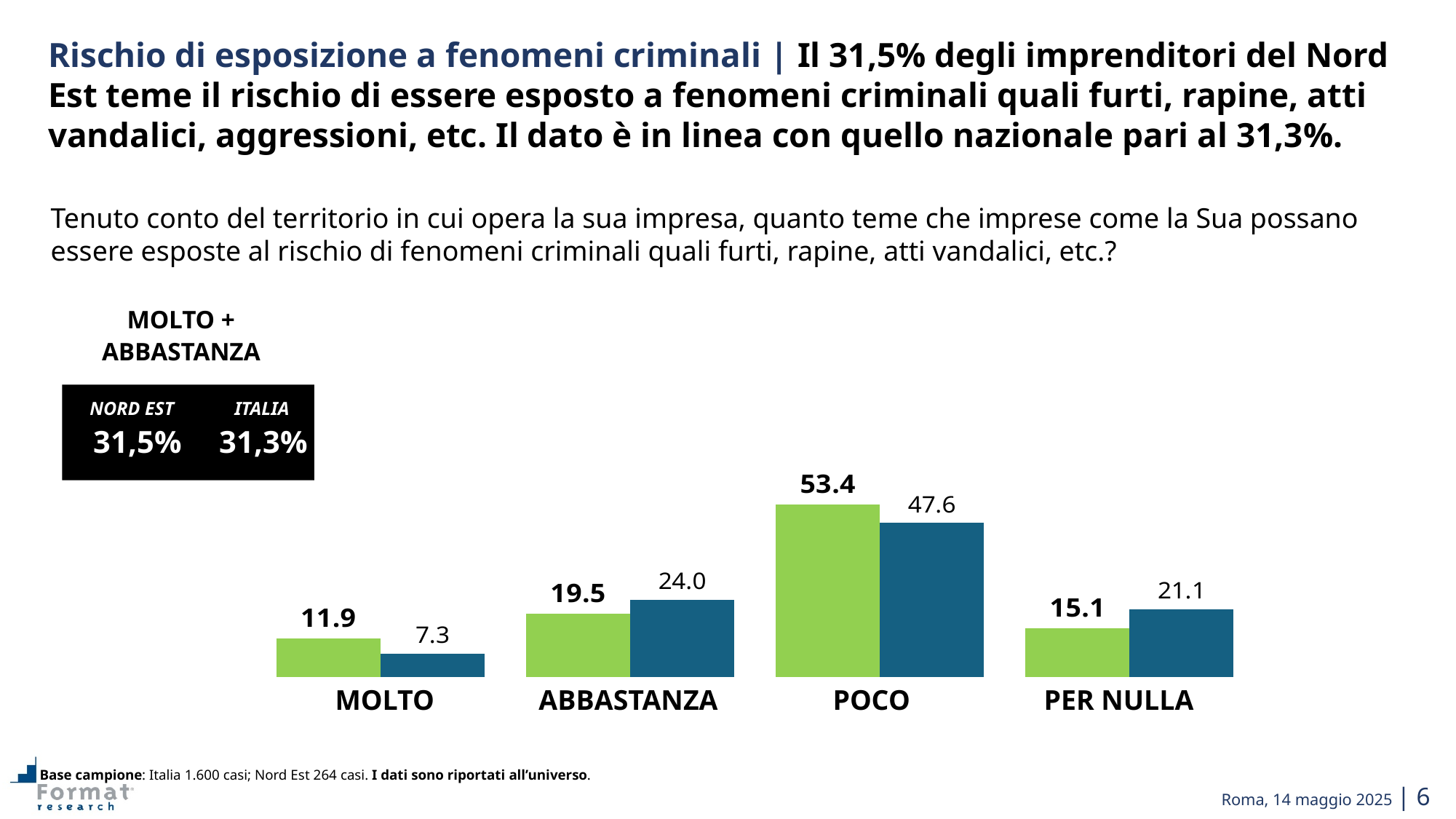
What is the value of the blue bar for MOLTO? 7.3 Which category has the highest green bar? POCO What is the value of the blue bar for ABBASTANZA? 24.0 What is the difference between the green and blue bars for POCO? 5.8 How many categories are shown on the x axis of the chart? 4 For ABBASTANZA, which bar is larger, the green or the blue one? blue Which category has the lowest blue bar? MOLTO What is the value of the green bar for PER NULLA? 15.1 What type of chart is shown on the slide? bar chart What is the difference between the blue bar for PER NULLA and the green bar for PER NULLA? 6.0 What is the value of the green bar for POCO? 53.4 What percentage is shown for NORD EST in the black box labelled MOLTO + ABBASTANZA? 31,5%